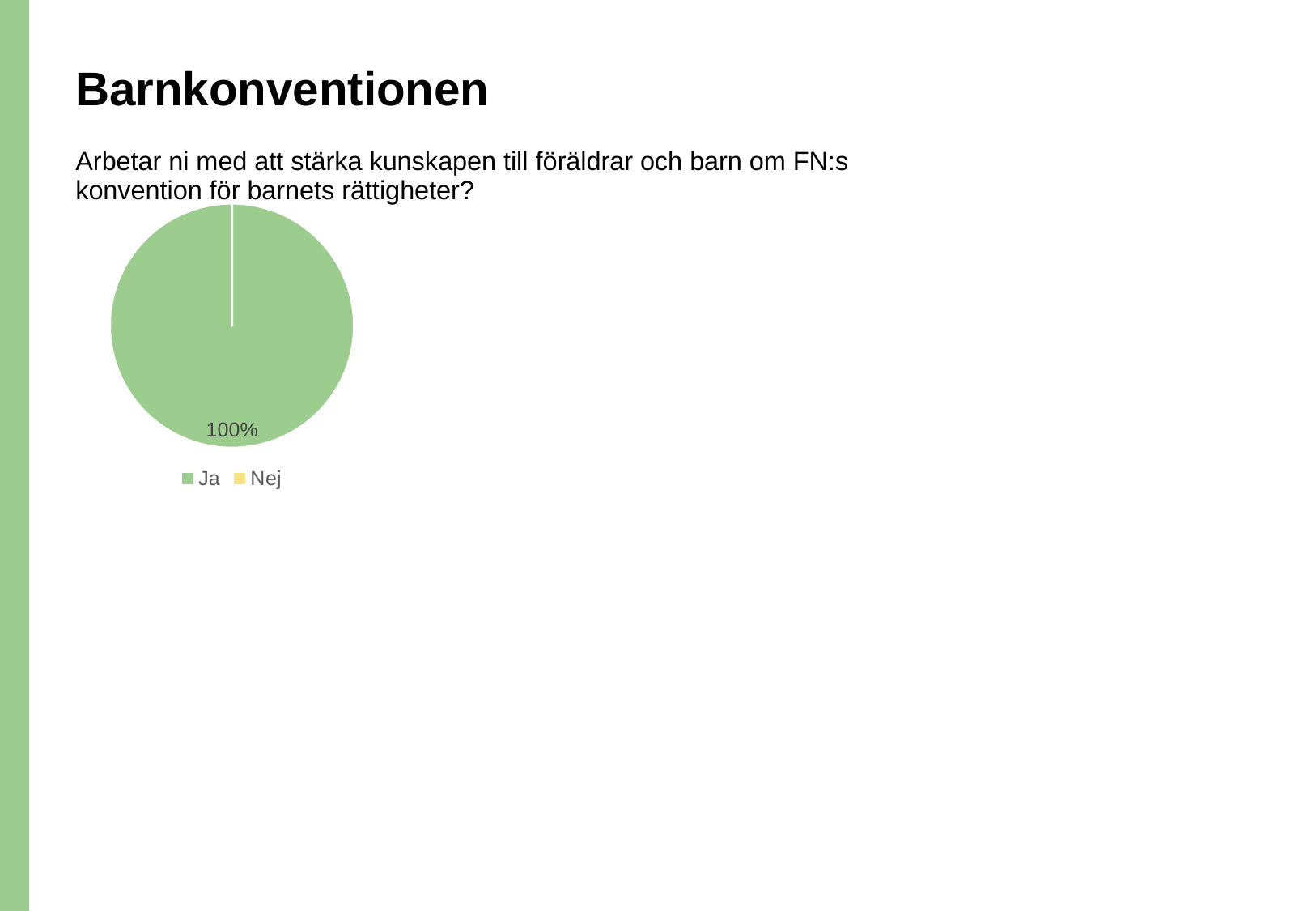
What kind of chart is shown on the slide? pie chart What share of the pie does "Ja" represent? 100% Which is larger, the share for "Ja" or the share for "Nej"? Ja Which category has the largest share of the pie? Ja How many entries does the legend list? 2 Which category has the smallest share of the pie? Nej What colour is used for "Ja" in the chart? green What is the only data label printed on the pie chart? 100% What colour is used for "Nej" in the legend? yellow